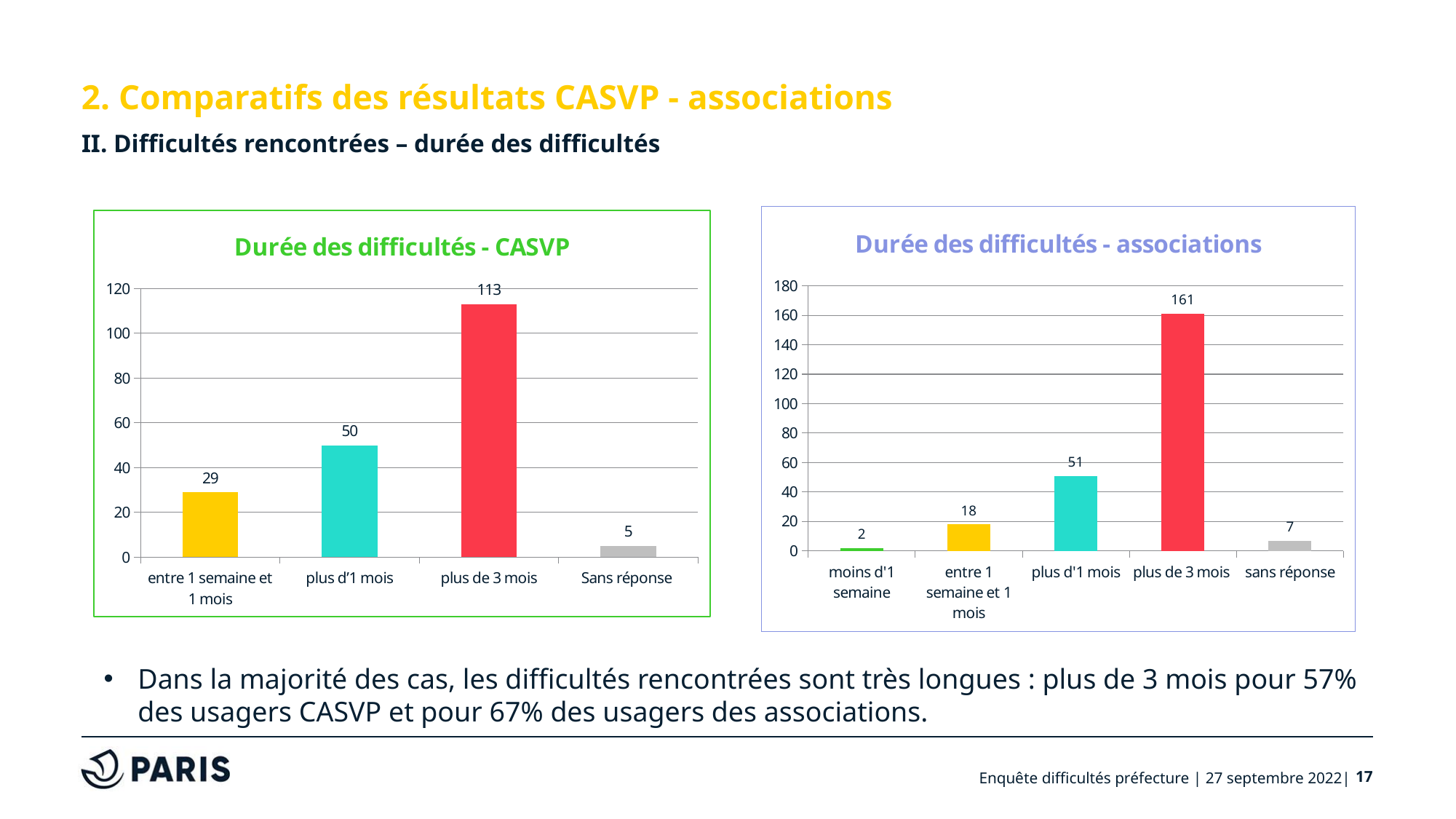
In the 'Durée des difficultés - associations' chart, which category has the lowest value? moins d'1 semaine In the 'Durée des difficultés - CASVP' chart, what is the value for 'plus de 3 mois'? 113 In the 'Durée des difficultés - associations' chart, which category has the highest value? plus de 3 mois In the 'Durée des difficultés - associations' chart, what is the value for 'entre 1 semaine et 1 mois'? 18 In the 'Durée des difficultés - CASVP' chart, which is larger: 'entre 1 semaine et 1 mois' or 'plus d'1 mois'? plus d'1 mois How many categories are shown in the 'Durée des difficultés - associations' chart? 5 In the 'Durée des difficultés - CASVP' chart, what is the difference between 'plus de 3 mois' and 'plus d'1 mois'? 63 How many categories are shown in the 'Durée des difficultés - CASVP' chart? 4 In the 'Durée des difficultés - CASVP' chart, which category has the lowest value? Sans réponse What type of chart is 'Durée des difficultés - CASVP'? Bar chart In the 'Durée des difficultés - associations' chart, what is the difference between 'plus de 3 mois' and 'plus d'1 mois'? 110 In the 'Durée des difficultés - associations' chart, what colour is the bar for 'plus de 3 mois'? Red